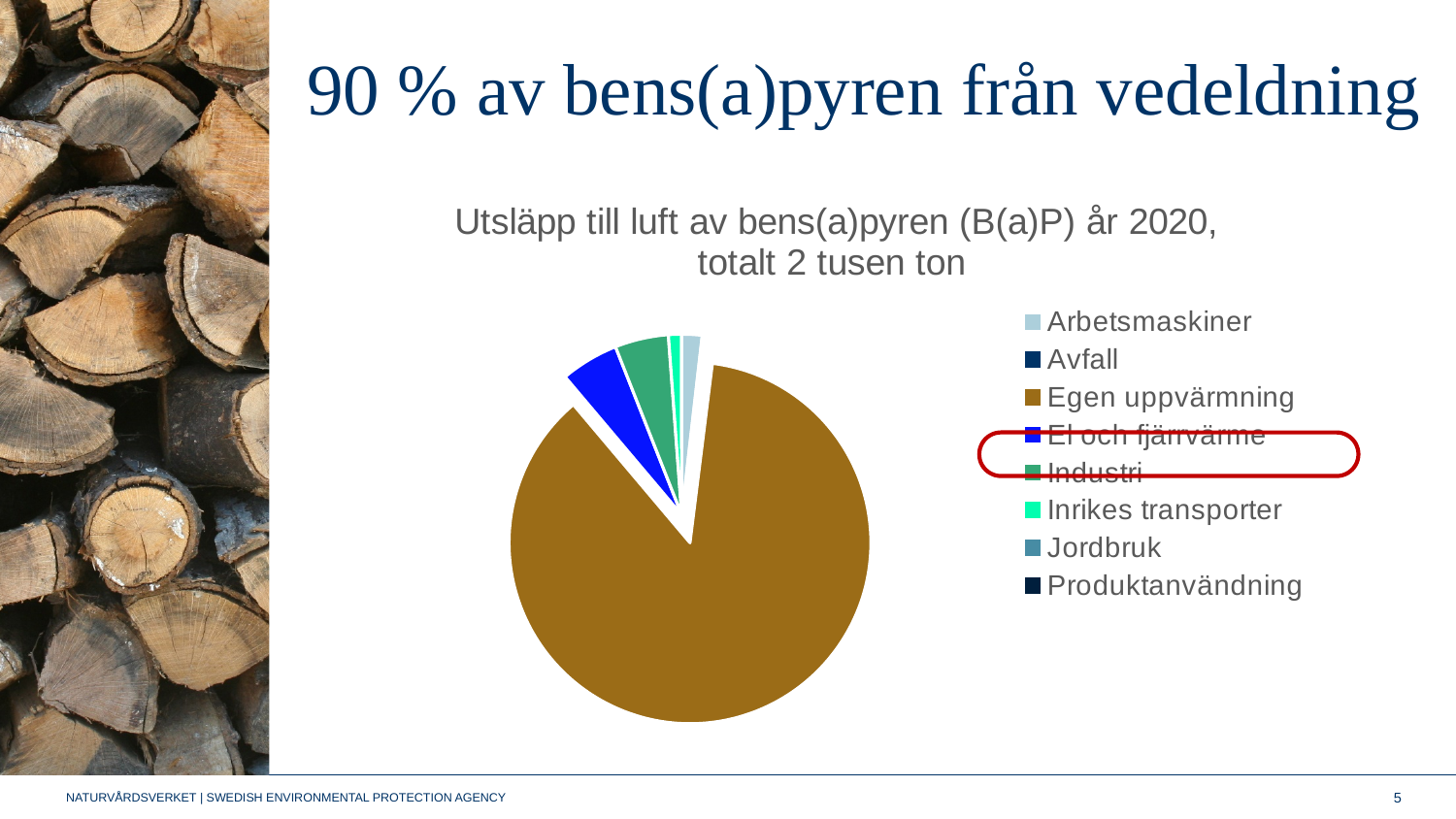
Which is larger, the slice for El och fjärrvärme or the slice for Inrikes transporter? El och fjärrvärme Which category has the largest slice of the pie? Egen uppvärmning How many categories does the chart legend list? 8 What is the title of the chart? Utsläpp till luft av bens(a)pyren (B(a)P) år 2020, totalt 2 tusen ton Which legend entry is listed last in the chart legend? Produktanvändning What total amount does the chart title state for the emissions? 2 tusen ton Which is larger, the slice for Egen uppvärmning or the slice for Industri? Egen uppvärmning What kind of chart is shown on the slide? Pie chart Which year does the chart's data refer to? 2020 Which is larger, the slice for Egen uppvärmning or the slice for El och fjärrvärme? Egen uppvärmning